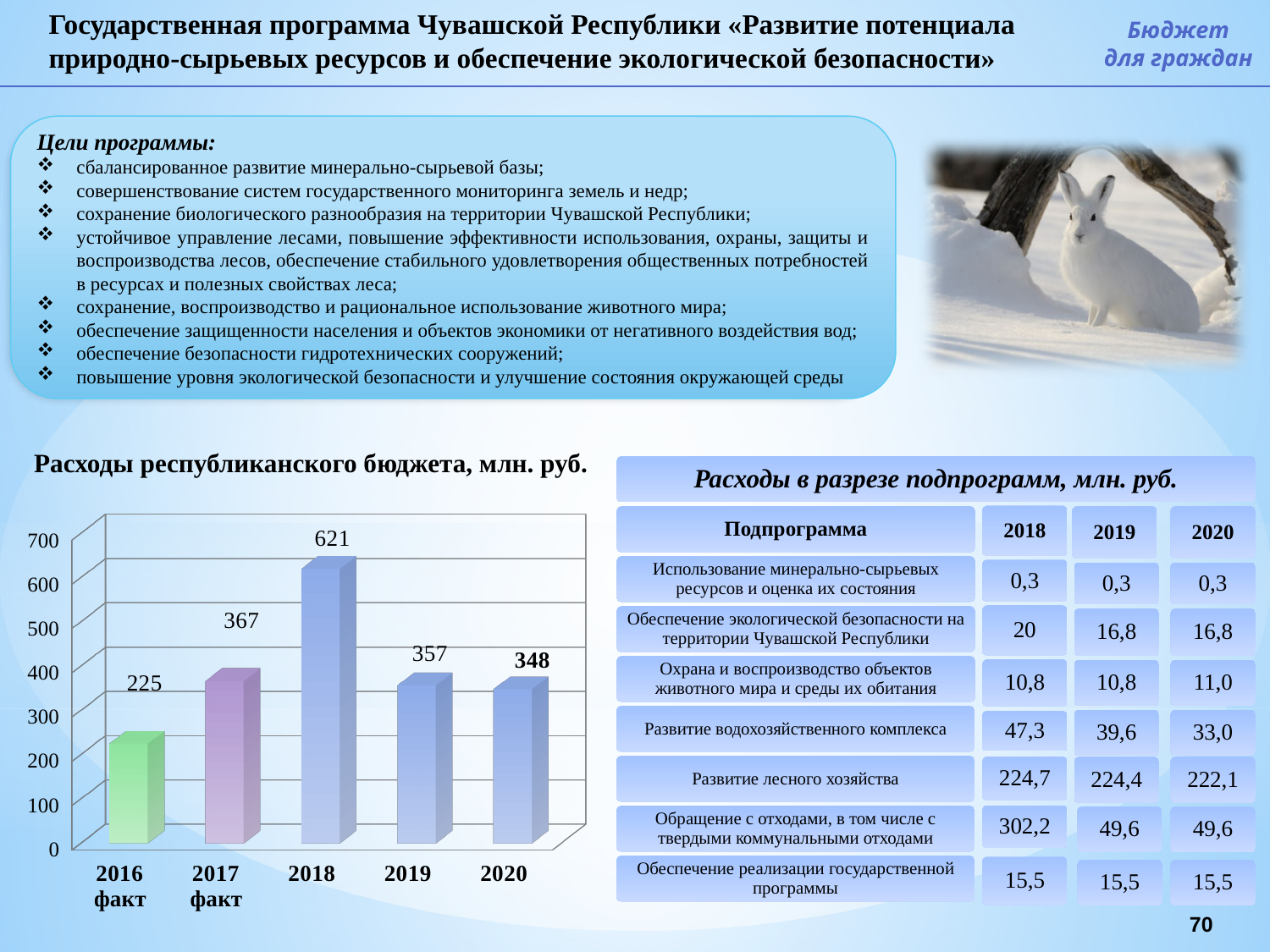
In the chart 'Расходы республиканского бюджета, млн. руб.', do the values rise or fall from 2018 to 2020? fall What is the value for 2018 in the chart 'Расходы республиканского бюджета, млн. руб.'? 621 What is the value for 2016 факт in the chart 'Расходы республиканского бюджета, млн. руб.'? 225 Which year has the lowest value in the chart 'Расходы республиканского бюджета, млн. руб.'? 2016 факт What is the difference between the values for 2018 and 2019 in the chart 'Расходы республиканского бюджета, млн. руб.'? 264 How many years are shown on the x axis of the chart 'Расходы республиканского бюджета, млн. руб.'? 5 Is the value for 2018 in the chart 'Расходы республиканского бюджета, млн. руб.' greater or less than 600? greater In the chart 'Расходы республиканского бюджета, млн. руб.', which is larger: the value for 2017 факт or the value for 2019? 2017 факт What kind of chart is 'Расходы республиканского бюджета, млн. руб.'? bar chart What is the difference between the values for 2017 факт and 2016 факт in the chart 'Расходы республиканского бюджета, млн. руб.'? 142 What is the value for 2020 in the chart 'Расходы республиканского бюджета, млн. руб.'? 348 Which year has the highest value in the chart 'Расходы республиканского бюджета, млн. руб.'? 2018